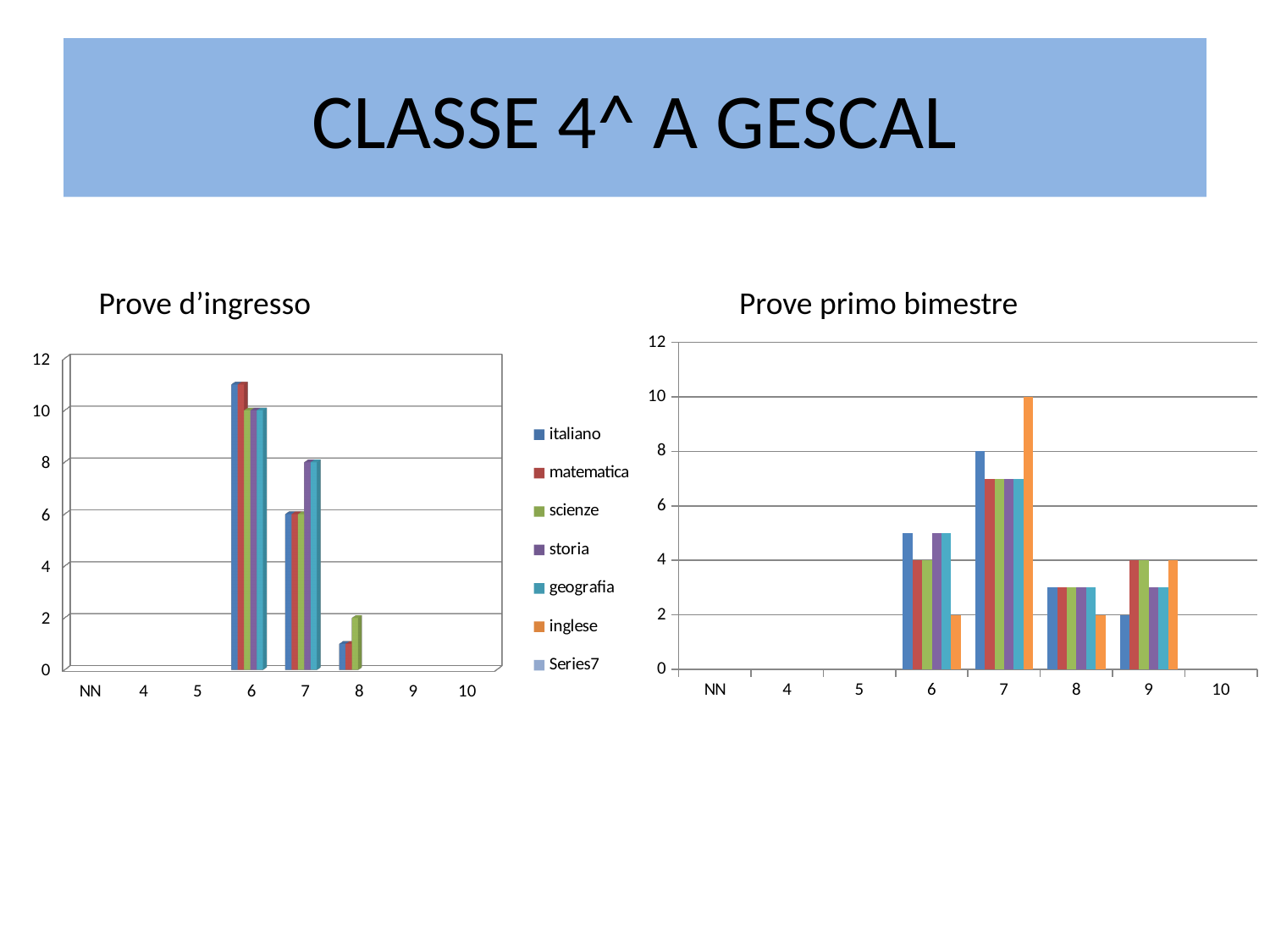
In the 'Prove primo bimestre' chart, what is the value for italiano at category 7? 8 How many series does the legend between the two charts list? 7 In the 'Prove primo bimestre' chart, what is the value for inglese at category 7? 10 How many categories are shown on the x axis of the 'Prove primo bimestre' chart? 8 In the 'Prove primo bimestre' chart, at category 6, which is larger: italiano or inglese? italiano What kind of chart is the 'Prove primo bimestre' chart? bar chart In the 'Prove primo bimestre' chart, what is the value for inglese at category 6? 2 In the 'Prove d'ingresso' chart, is the value for scienze at category 8 greater or less than 4? less In the 'Prove primo bimestre' chart, which category contains the tallest bar? 7 What is the title of the chart on the left of the slide? Prove d'ingresso In the 'Prove d'ingresso' chart, which category has the larger italiano value: 6 or 7? 6 In the 'Prove d'ingresso' chart, is the value for italiano at category 6 greater or less than 10? greater